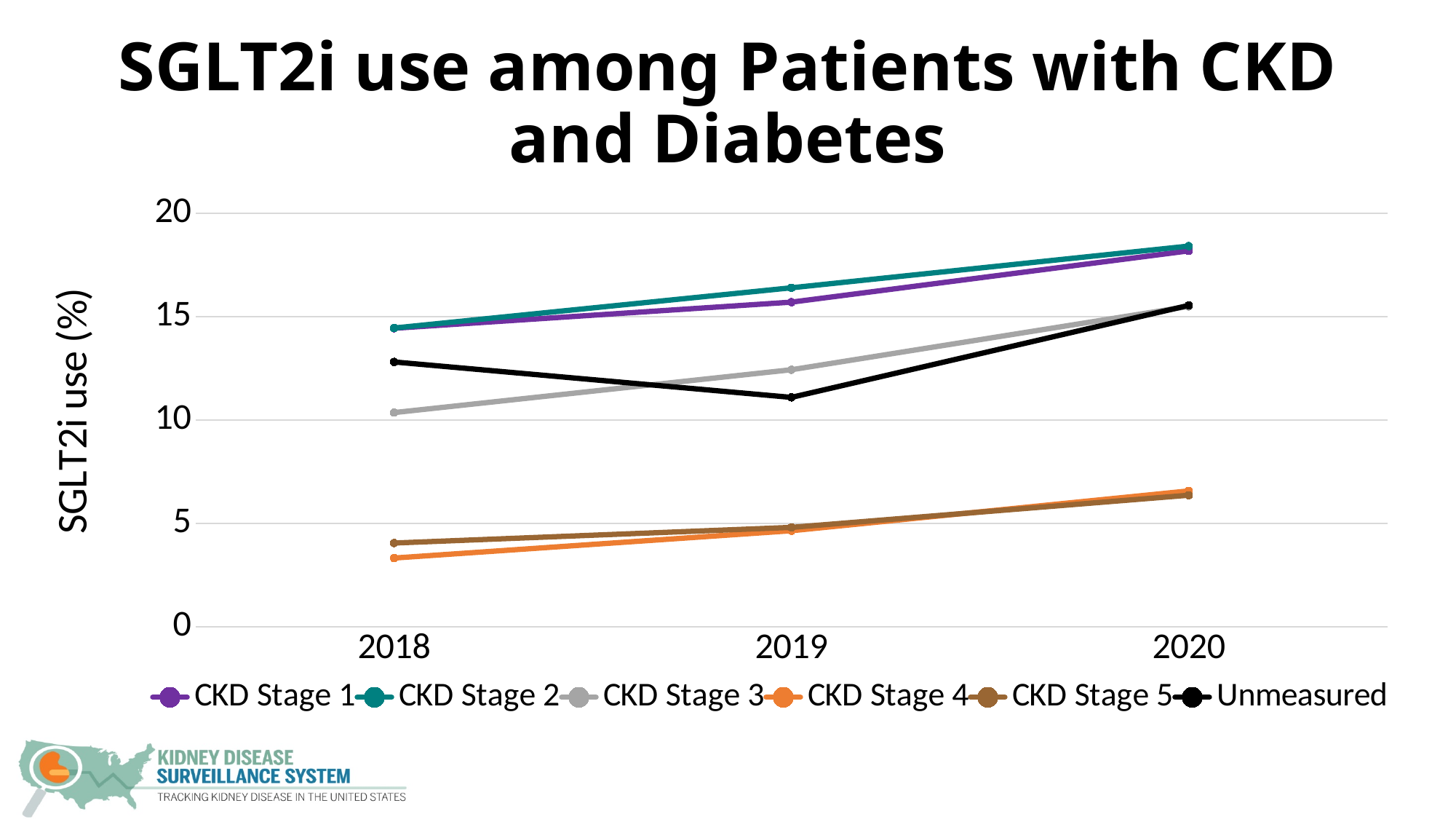
In 2018, which is larger: the value for Unmeasured or the value for CKD Stage 3? Unmeasured Which series has the lowest SGLT2i use in 2018? CKD Stage 4 In 2019, which is larger: the value for CKD Stage 3 or the value for Unmeasured? CKD Stage 3 Does the Unmeasured series rise or fall from 2018 to 2019? fall Is the value for Unmeasured in 2019 greater or less than 10? greater How many years are shown on the x axis? 3 How many series does the legend list? 6 What kind of chart is shown on the slide? line chart Is the value for CKD Stage 4 in 2018 greater or less than 5? less Which series has the highest SGLT2i use in 2019? CKD Stage 2 What is the label of the y axis? SGLT2i use (%) Is the value for CKD Stage 2 in 2020 greater or less than 20? less